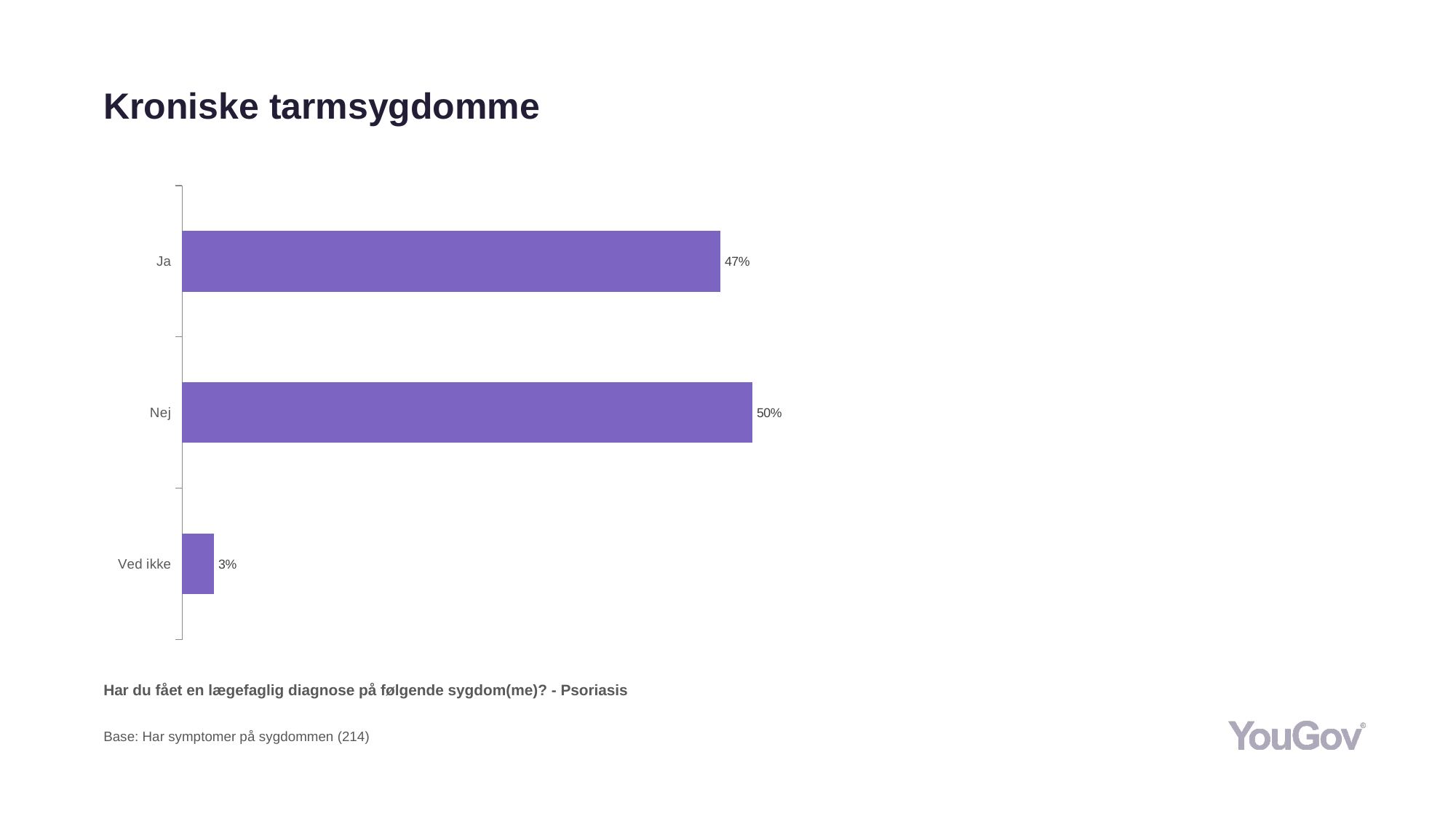
What is the value for Nej? 50% Which is larger, the value for Ja or the value for Ved ikke? Ja Which category has the highest value? Nej What is the base size stated below the chart? 214 What kind of chart is shown on the slide? Bar chart What is the difference between the values for Nej and Ja? 3% What is the difference between the values for Ja and Ved ikke? 44% What is the value for Ja? 47% What is the title of the slide? Kroniske tarmsygdomme What is the value for Ved ikke? 3% How many categories are shown in the chart? 3 Which category has the lowest value? Ved ikke